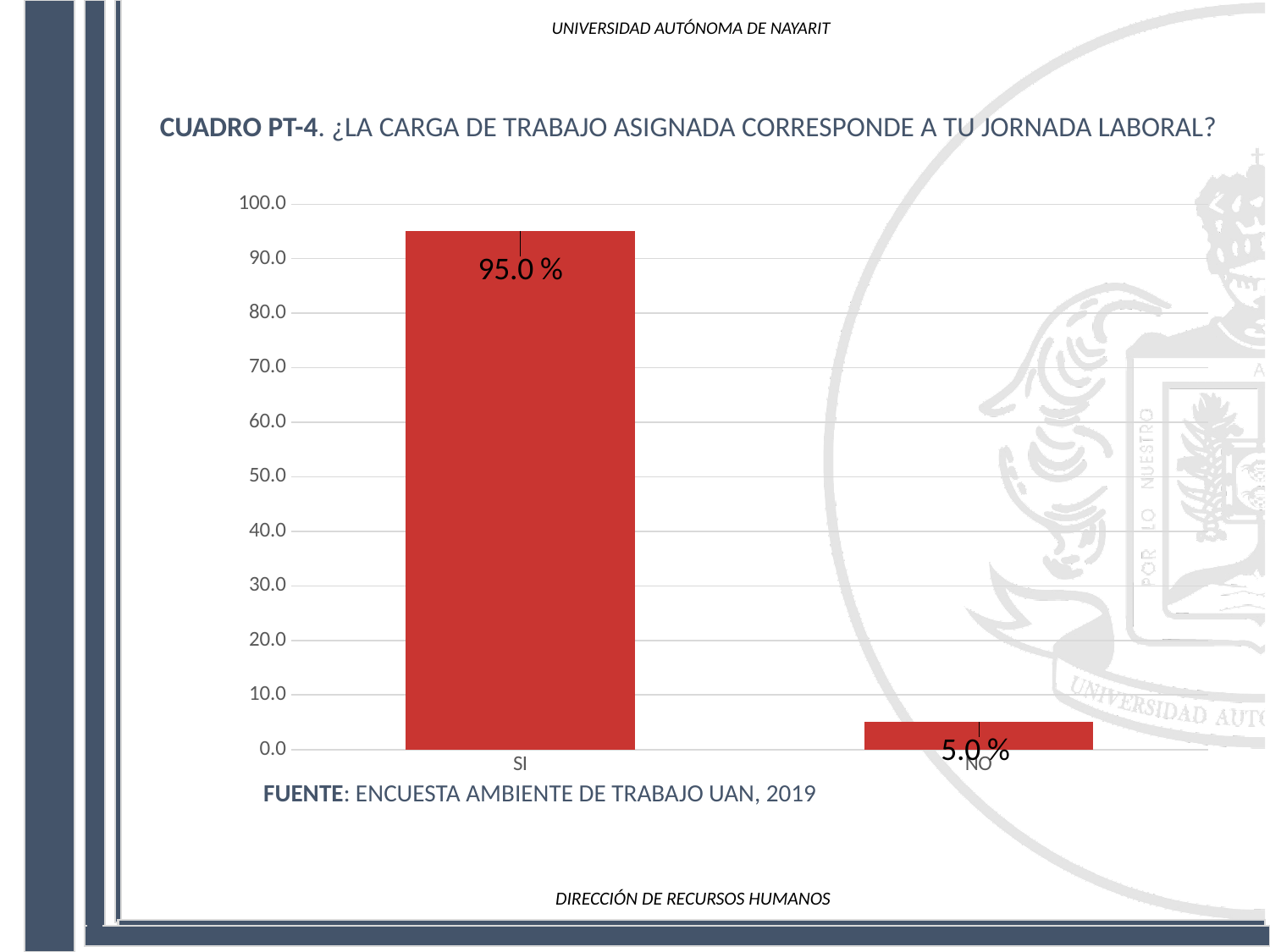
What is the value for SI? 95.0 % Is the value for SI greater or less than 90.0? greater What is the value for NO? 5.0 % How many categories are shown on the x axis? 2 What is the difference between the values for SI and NO? 90.0 % What is the title of the chart? CUADRO PT-4. ¿LA CARGA DE TRABAJO ASIGNADA CORRESPONDE A TU JORNADA LABORAL? Which category has the highest value? SI What colour are the bars in the chart? red Which is larger, the value for SI or the value for NO? SI Is the value for NO greater or less than 10.0? less Which category has the lowest value? NO What kind of chart is shown on the slide? bar chart